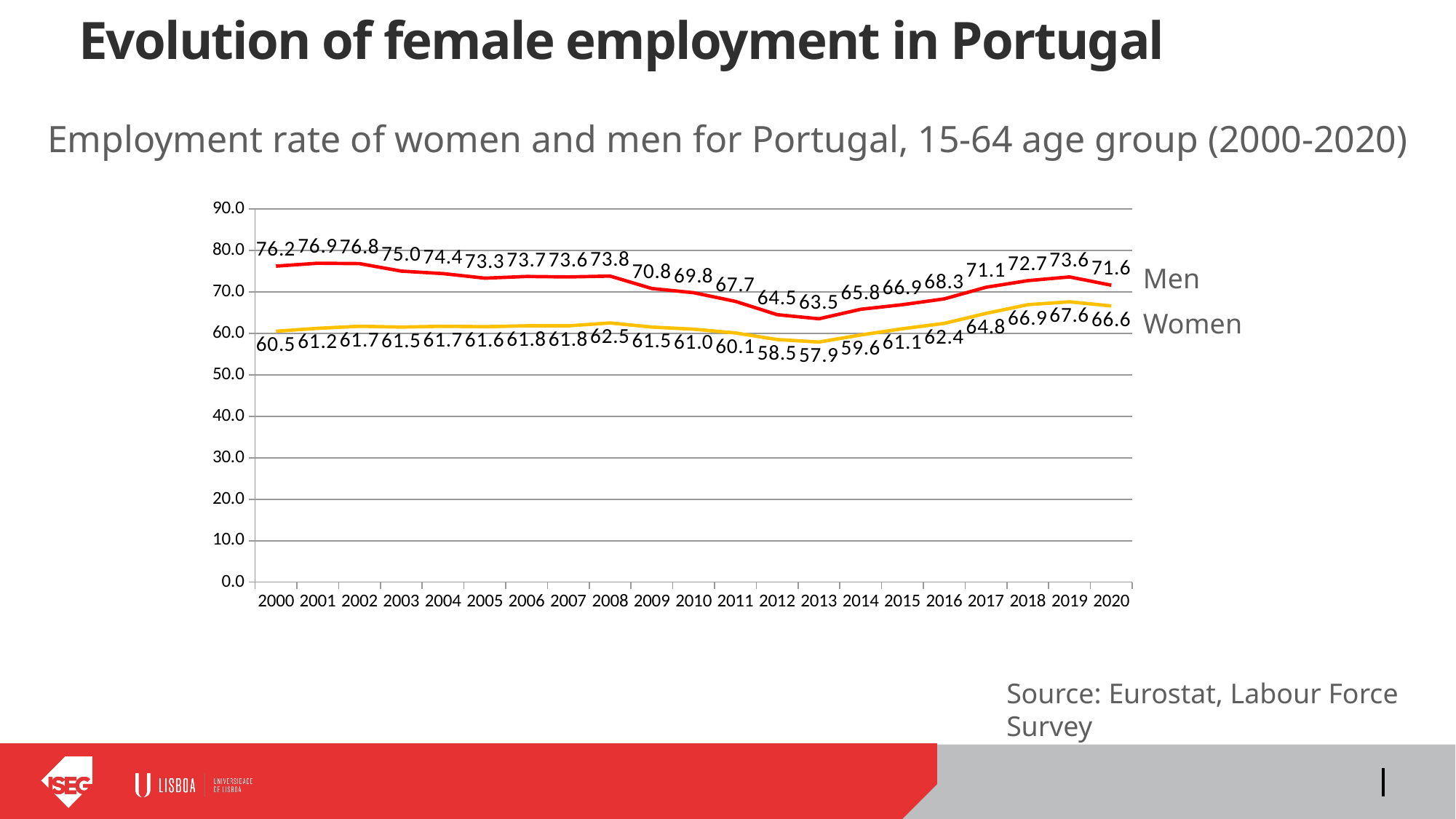
How many series does the chart show? 2 Which is larger, the men's employment rate in 2001 or in 2019? 2001 What is the difference between the women's employment rate in 2019 and in 2013? 9.7 Does the men's employment rate rise or fall from 2013 to 2019? Rise In which year is the employment rate for women highest? 2019 How many years are shown on the x axis? 21 What is the employment rate for women in 2013? 57.9 In which year is the employment rate for men lowest? 2013 What is the employment rate for men in 2000? 76.2 What kind of chart is shown on the slide? Line chart What is the difference between the men's and women's employment rates in 2020? 5.0 What is the employment rate for women in 2020? 66.6